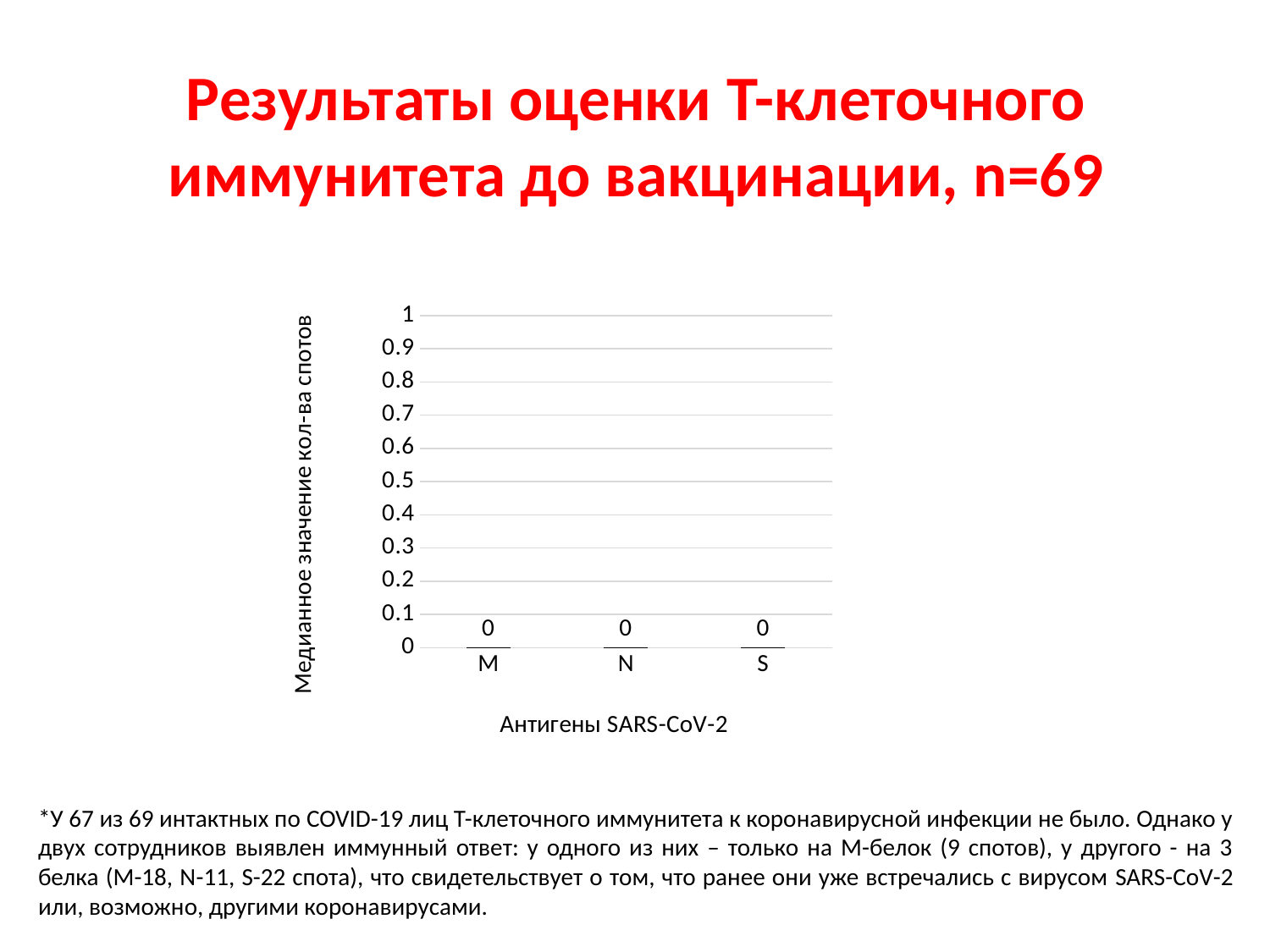
What is the highest value shown on the y axis? 1 What is the value for M? 0 What kind of chart is shown on the slide? bar chart What is the value for N? 0 What is the title of the x axis? Антигены SARS-CoV-2 How many categories are shown on the x axis? 3 What is the value for S? 0 What is the difference between the values for M and N? 0 Is the value for M greater or less than 0.5? less Is the value for S greater or less than 0.1? less What is the title of the y axis? Медианное значение кол-ва спотов